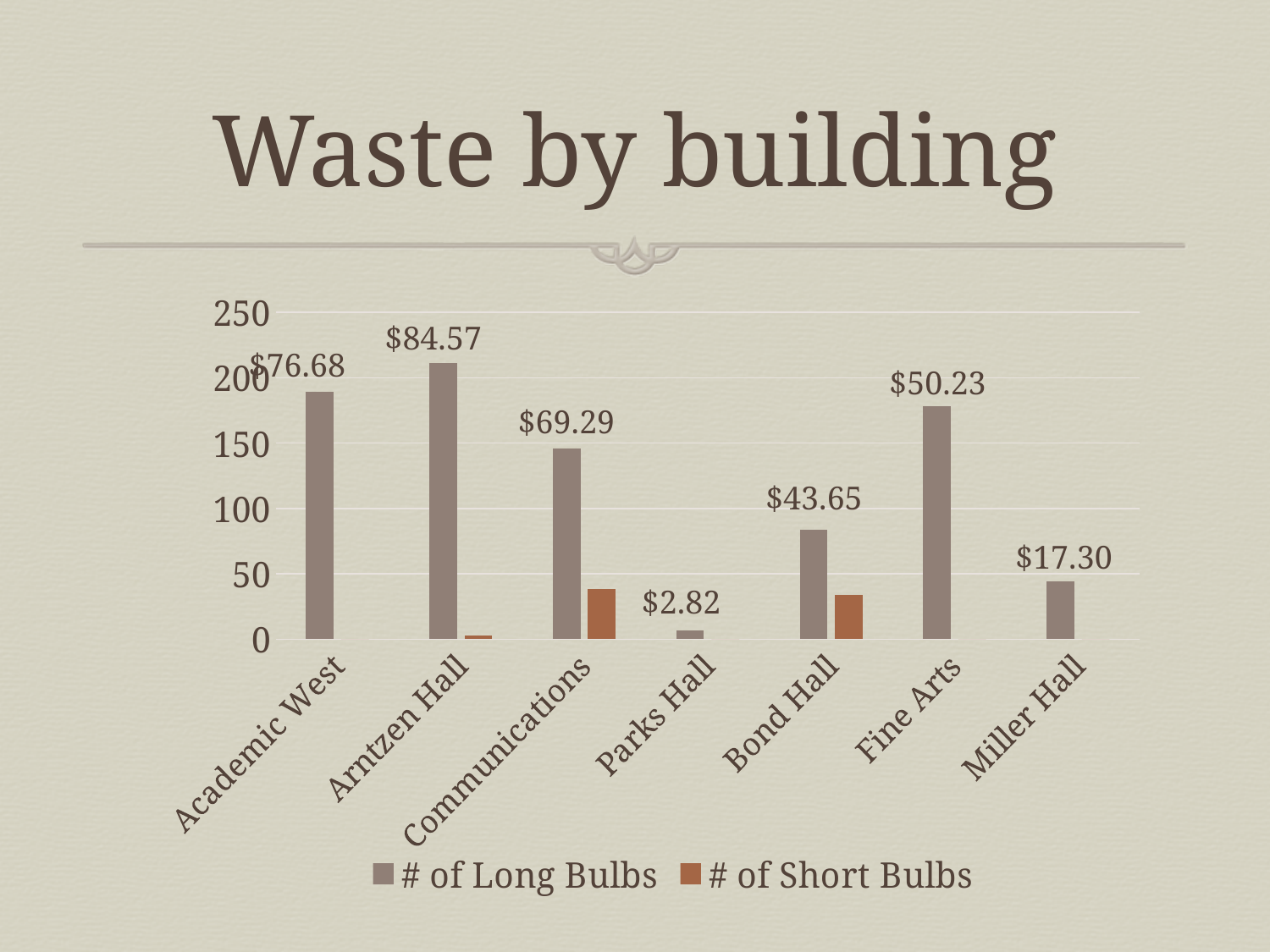
What dollar amount is printed above the Parks Hall bar? $2.82 Which has more long bulbs, Fine Arts or Bond Hall? Fine Arts Which building has the lowest number of long bulbs? Parks Hall Is the number of long bulbs for Communications greater or less than 100? greater How many series does the legend list? 2 Is the number of long bulbs for Bond Hall greater or less than 100? less What kind of chart is shown on the slide? bar chart How many buildings are shown on the x axis? 7 Which building has the highest number of long bulbs? Arntzen Hall What is the title of the slide? Waste by building What dollar amount is printed above the Arntzen Hall bars? $84.57 Is the number of long bulbs for Academic West greater or less than 150? greater